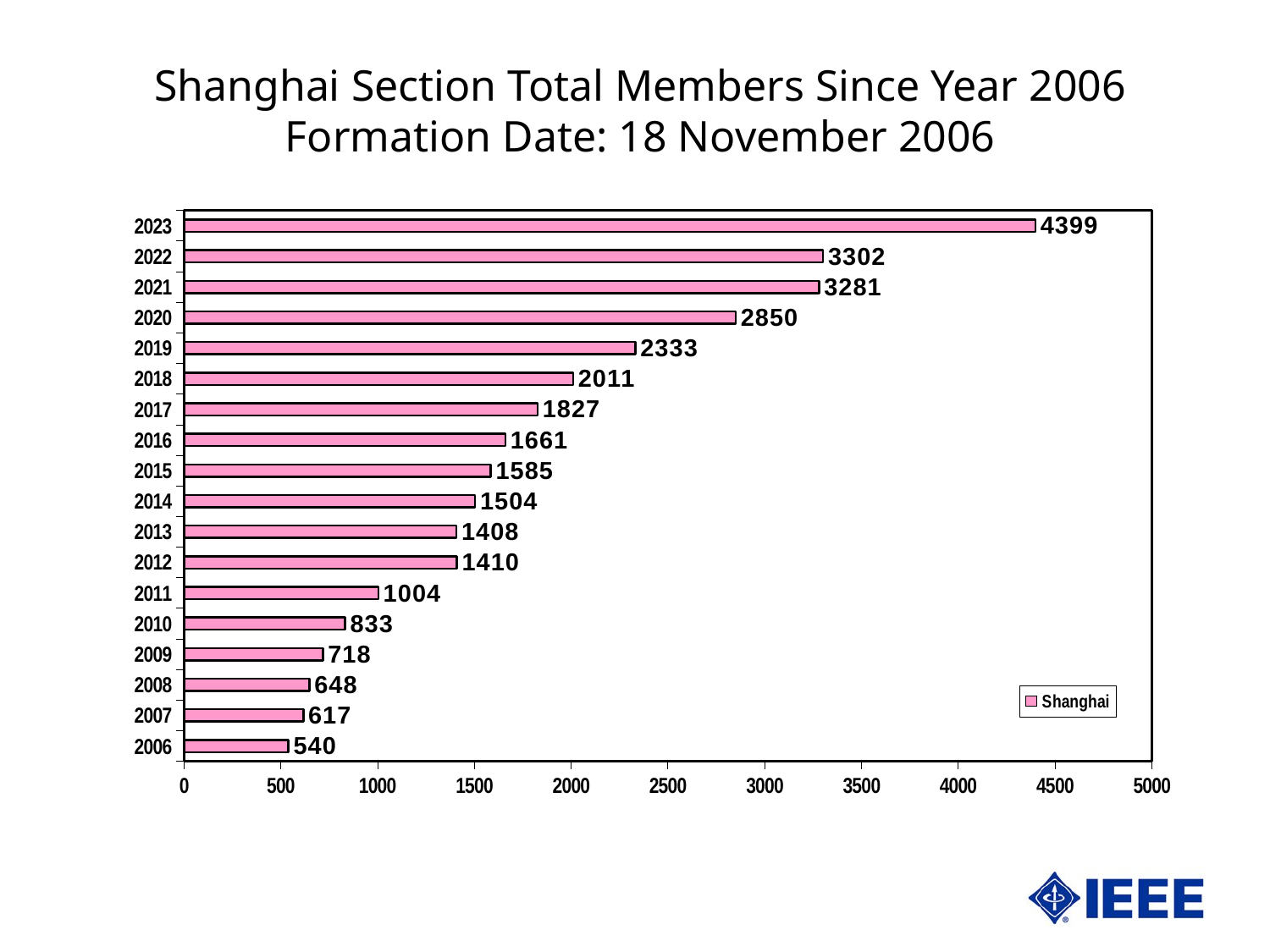
Which year has the lowest value? 2006 Which year has the highest value? 2023 What is the difference between the values for 2023 and 2022? 1097 What is the value for 2023? 4399 What kind of chart is shown? bar chart What is the value for 2015? 1585 Is the value for 2020 greater or less than 2500? greater How many years are shown on the chart? 18 What is the value for 2006? 540 Which is larger, the value for 2012 or the value for 2013? 2012 What series name is shown in the legend? Shanghai How many series does the legend list? 1